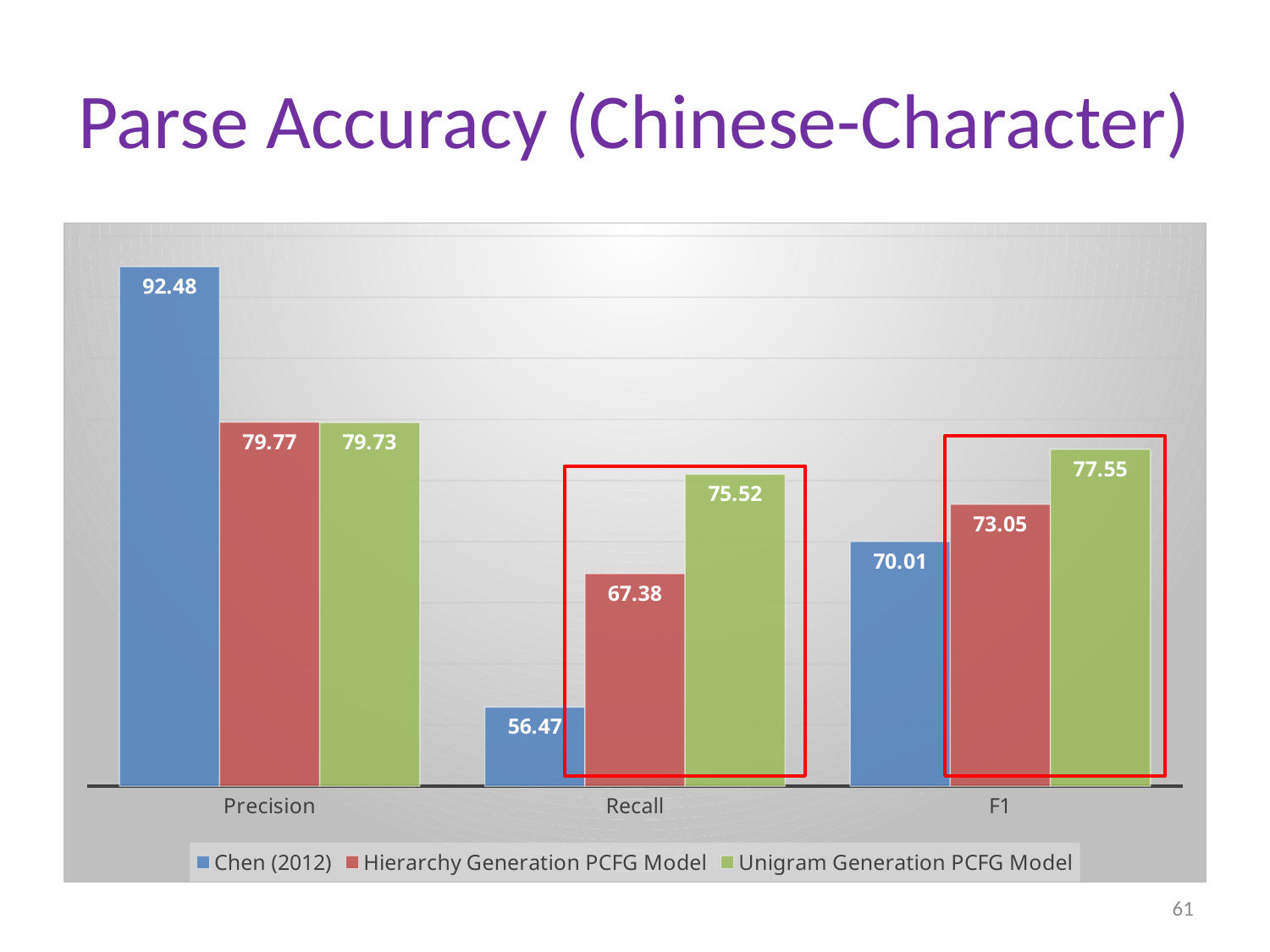
How many series does the legend list? 3 What is the Recall value for the Unigram Generation PCFG Model? 75.52 What is the Precision value for Chen (2012)? 92.48 What is the difference between the F1 values of the Unigram Generation PCFG Model and the Hierarchy Generation PCFG Model? 4.50 Which series has the lowest Recall value? Chen (2012) What is the F1 value for the Hierarchy Generation PCFG Model? 73.05 What kind of chart is shown on the slide? Bar chart What is the difference between the Recall values of the Unigram Generation PCFG Model and Chen (2012)? 19.05 Which series has the highest F1 value? Unigram Generation PCFG Model How many categories are shown on the x axis? 3 What is the title of the slide? Parse Accuracy (Chinese-Character) Which is larger: the Recall value for the Hierarchy Generation PCFG Model or the F1 value for Chen (2012)? F1 value for Chen (2012)